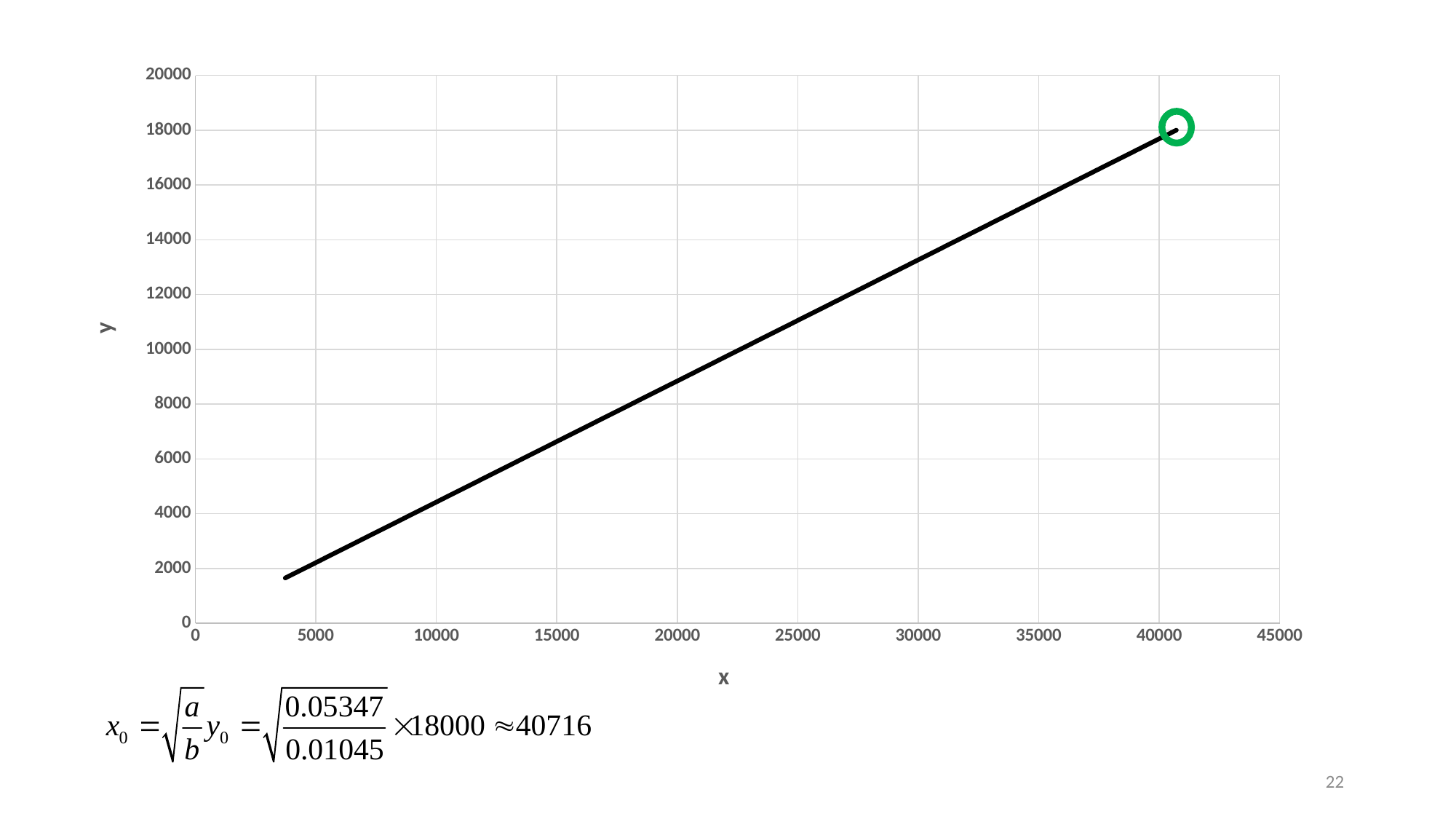
Is the value of y at x = 20000 greater or less than 10000? less Does y rise or fall as x increases along the x axis? rise What is the label of the horizontal axis? x What kind of chart is shown on the slide? line chart Is the value of y at x = 40000 greater or less than 16000? greater What is the label of the vertical axis? y Is the y value at the point marked by the green circle greater or less than 16000? greater What is the highest tick value shown on the x axis? 45000 What is the highest tick value shown on the y axis? 20000